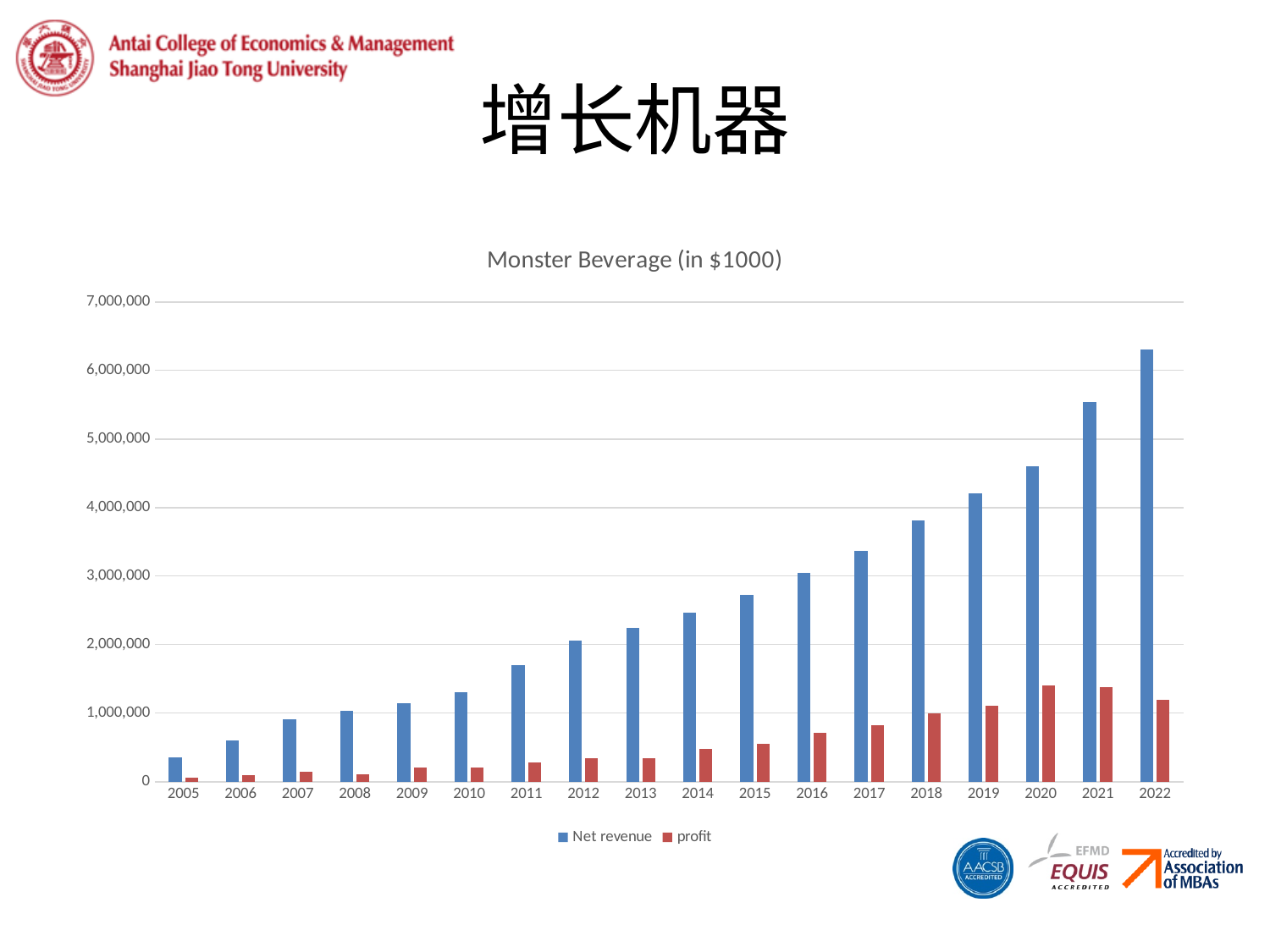
How many series does the legend list? 2 Is the profit for 2022 greater or less than 1,000,000? greater What kind of chart is shown on the slide? bar chart How many years are shown on the x axis? 18 Which year has the highest net revenue? 2022 Is the net revenue for 2022 greater or less than 6,000,000? greater Which year has the lowest net revenue? 2005 Which year has the lowest profit? 2005 Is the profit for 2017 greater or less than 1,000,000? less Which is larger, the profit for 2020 or the profit for 2022? 2020 Does net revenue rise or fall from 2005 to 2022? rise